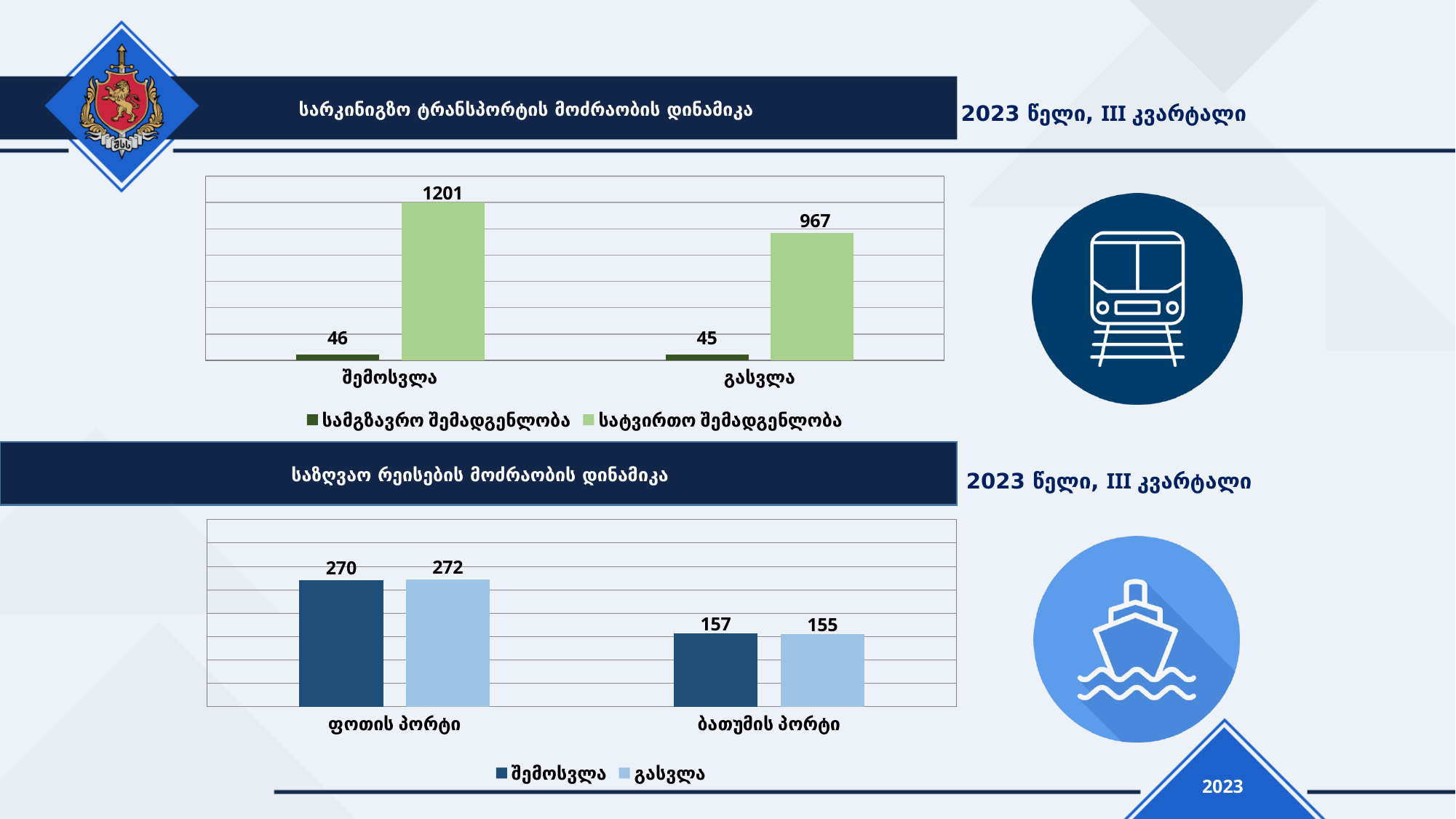
In the top chart (სარკინიგზო ტრანსპორტის მოძრაობის დინამიკა), what is the value of სატვირთო შემადგენლობა for შემოსვლა? 1201 In the bottom chart (საზღვაო რეისების მოძრაობის დინამიკა), what is the გასვლა value for ბათუმის პორტი? 155 What type of chart is the top chart (სარკინიგზო ტრანსპორტის მოძრაობის დინამიკა)? bar chart In the top chart (სარკინიგზო ტრანსპორტის მოძრაობის დინამიკა), what is the difference between the სატვირთო შემადგენლობა values for შემოსვლა and გასვლა? 234 In the bottom chart (საზღვაო რეისების მოძრაობის დინამიკა), what is the difference between the შემოსვლა values for ფოთის პორტი and ბათუმის პორტი? 113 In the bottom chart (საზღვაო რეისების მოძრაობის დინამიკა), which port has the lower გასვლა value? ბათუმის პორტი In the bottom chart (საზღვაო რეისების მოძრაობის დინამიკა), what are the two legend entries? შემოსვლა and გასვლა In the top chart (სარკინიგზო ტრანსპორტის მოძრაობის დინამიკა), how many series does the legend list? 2 In the bottom chart (საზღვაო რეისების მოძრაობის დინამიკა), what is the შემოსვლა value for ფოთის პორტი? 270 In the top chart (სარკინიგზო ტრანსპორტის მოძრაობის დინამიკა), which category has the higher სატვირთო შემადგენლობა value? შემოსვლა In the top chart (სარკინიგზო ტრანსპორტის მოძრაობის დინამიკა), what is the value of სამგზავრო შემადგენლობა for გასვლა? 45 In the bottom chart (საზღვაო რეისების მოძრაობის დინამიკა), how many categories are shown on the x axis? 2